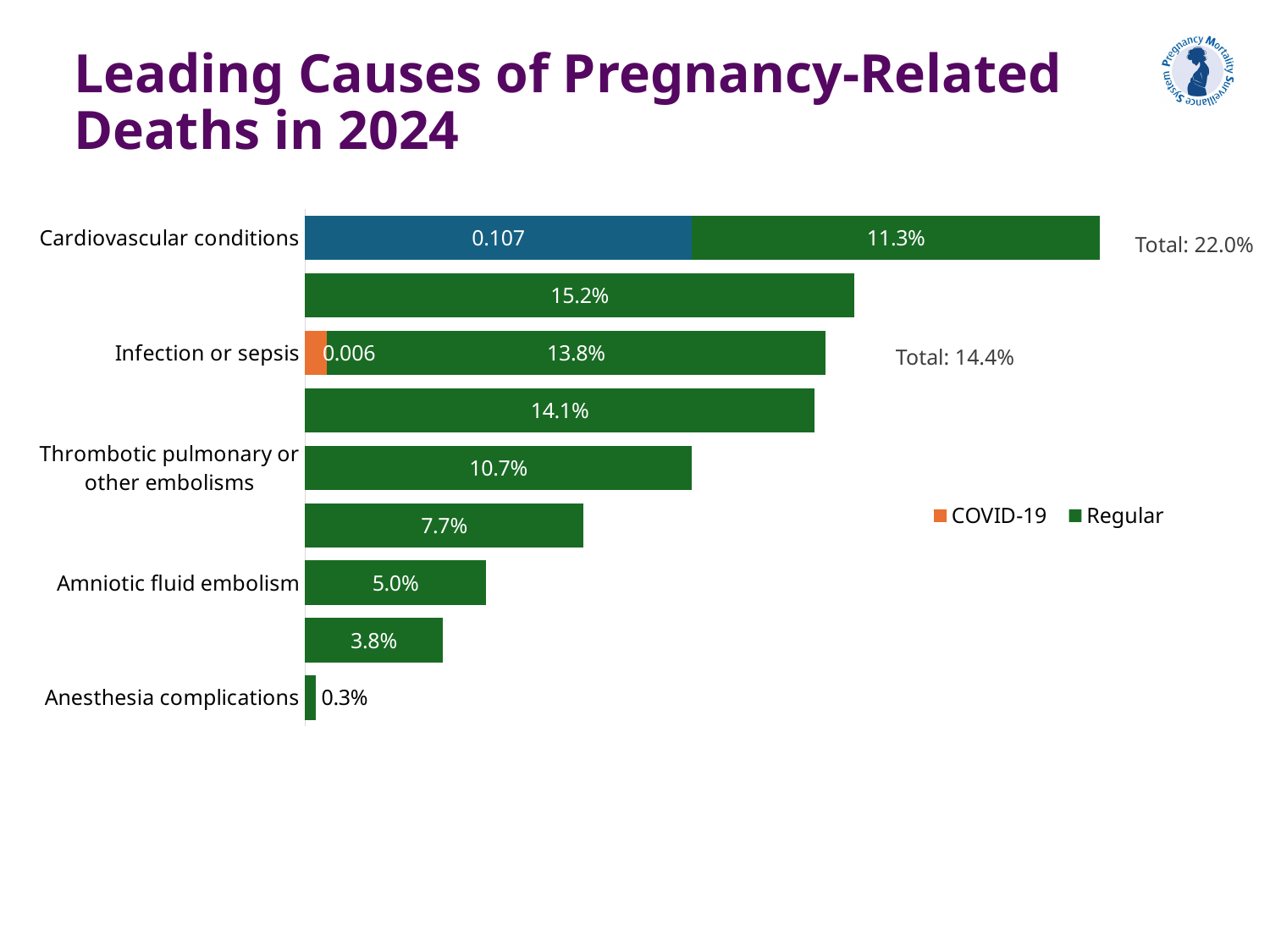
What kind of chart is shown on the slide? Bar chart Which labeled cause has the lowest value? Anesthesia complications What total is printed for the Infection or sepsis bar? 14.4% What is the difference between the values for Thrombotic pulmonary or other embolisms and Amniotic fluid embolism? 5.7% How many series does the legend list? 2 What is the Regular value for Infection or sepsis? 13.8% What total is printed for the Cardiovascular conditions bar? 22.0% What is the value for Thrombotic pulmonary or other embolisms? 10.7% What is the value for Anesthesia complications? 0.3% What is the Regular value for Cardiovascular conditions? 11.3% Which labeled cause has the highest total value? Cardiovascular conditions What is the COVID-19 value for Infection or sepsis? 0.006